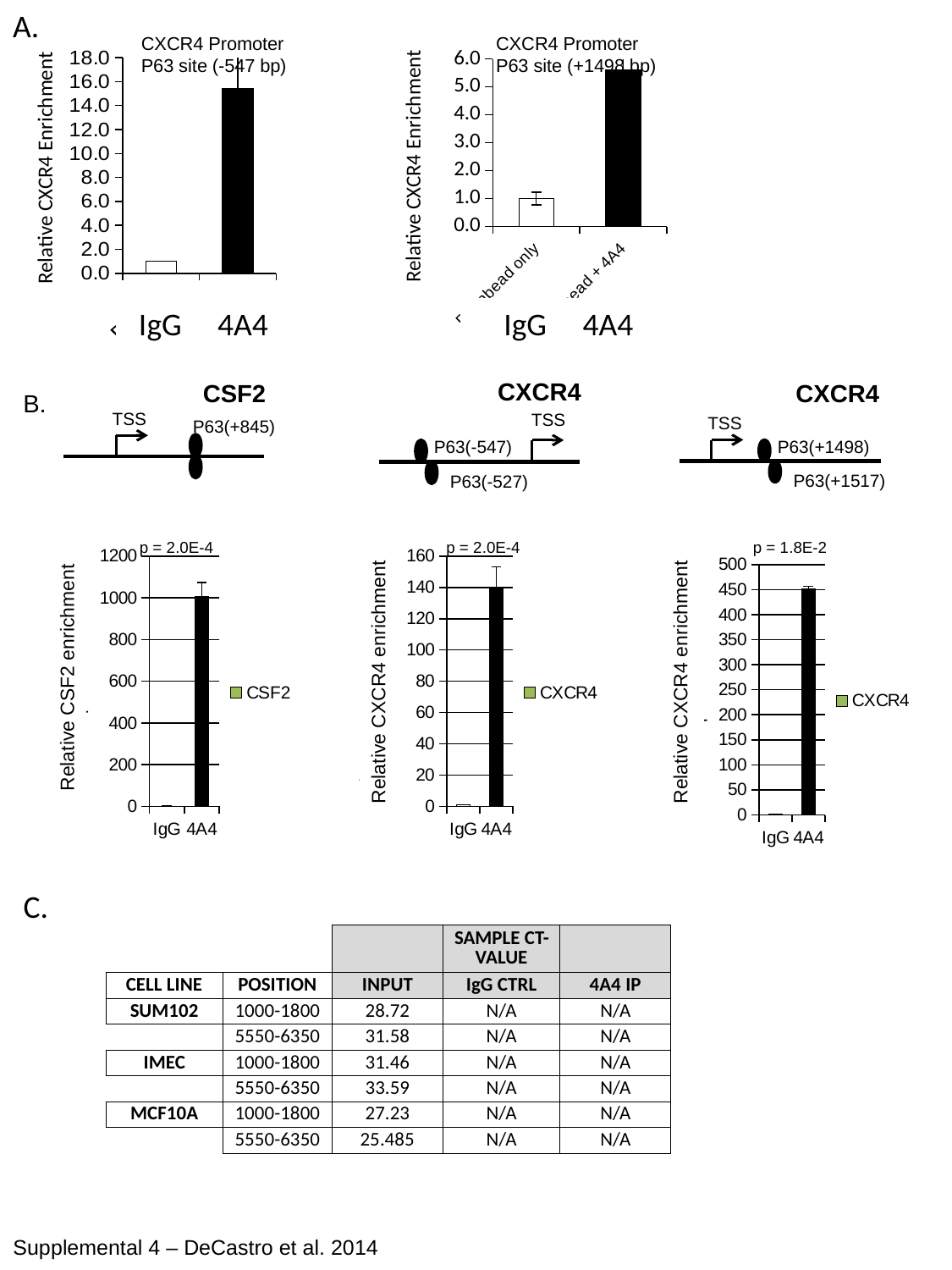
In the chart titled 'CXCR4 Promoter P63 site (-547 bp)', is the value for IgG greater or less than 2.0? less In the chart titled 'CXCR4 Promoter P63 site (+1498 bp)', which category has the lowest value? IgG In the chart titled 'CXCR4 Promoter P63 site (-547 bp)', which category has the highest value? 4A4 How many categories are shown on the x axis of the CSF2 chart in panel B? 2 In the rightmost chart of panel B, which is larger, IgG or 4A4? 4A4 In the middle chart of panel B (Relative CXCR4 enrichment, axis to 160), is the value for 4A4 greater or less than 120? greater What kind of chart is the CSF2 chart in panel B? bar chart What p-value is printed above the rightmost chart in panel B? p = 1.8E-2 In the chart titled 'CXCR4 Promoter P63 site (-547 bp)', is the value for 4A4 greater or less than 14.0? greater